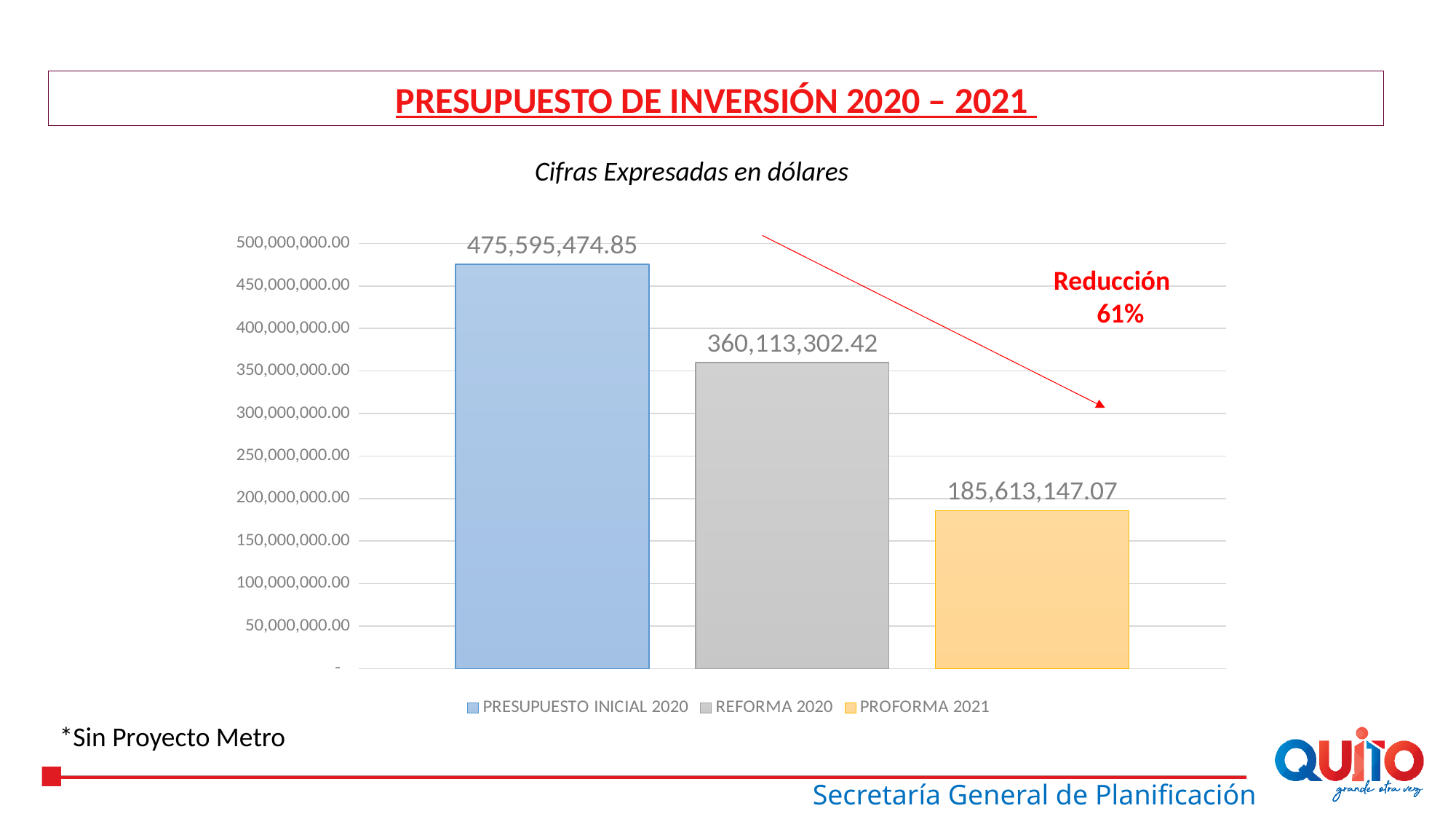
What is the difference between PRESUPUESTO INICIAL 2020 and REFORMA 2020? 115,482,172.43 Which is larger, REFORMA 2020 or PROFORMA 2021? REFORMA 2020 What percentage reduction is annotated on the chart? 61% Which series has the lowest value? PROFORMA 2021 What kind of chart is shown on the slide? bar chart What is the value for PRESUPUESTO INICIAL 2020? 475,595,474.85 What is the value for REFORMA 2020? 360,113,302.42 What is the value for PROFORMA 2021? 185,613,147.07 What is the difference between REFORMA 2020 and PROFORMA 2021? 174,500,155.35 Which series has the highest value? PRESUPUESTO INICIAL 2020 Is the value for PROFORMA 2021 greater or less than 200,000,000.00? less How many series does the legend list? 3